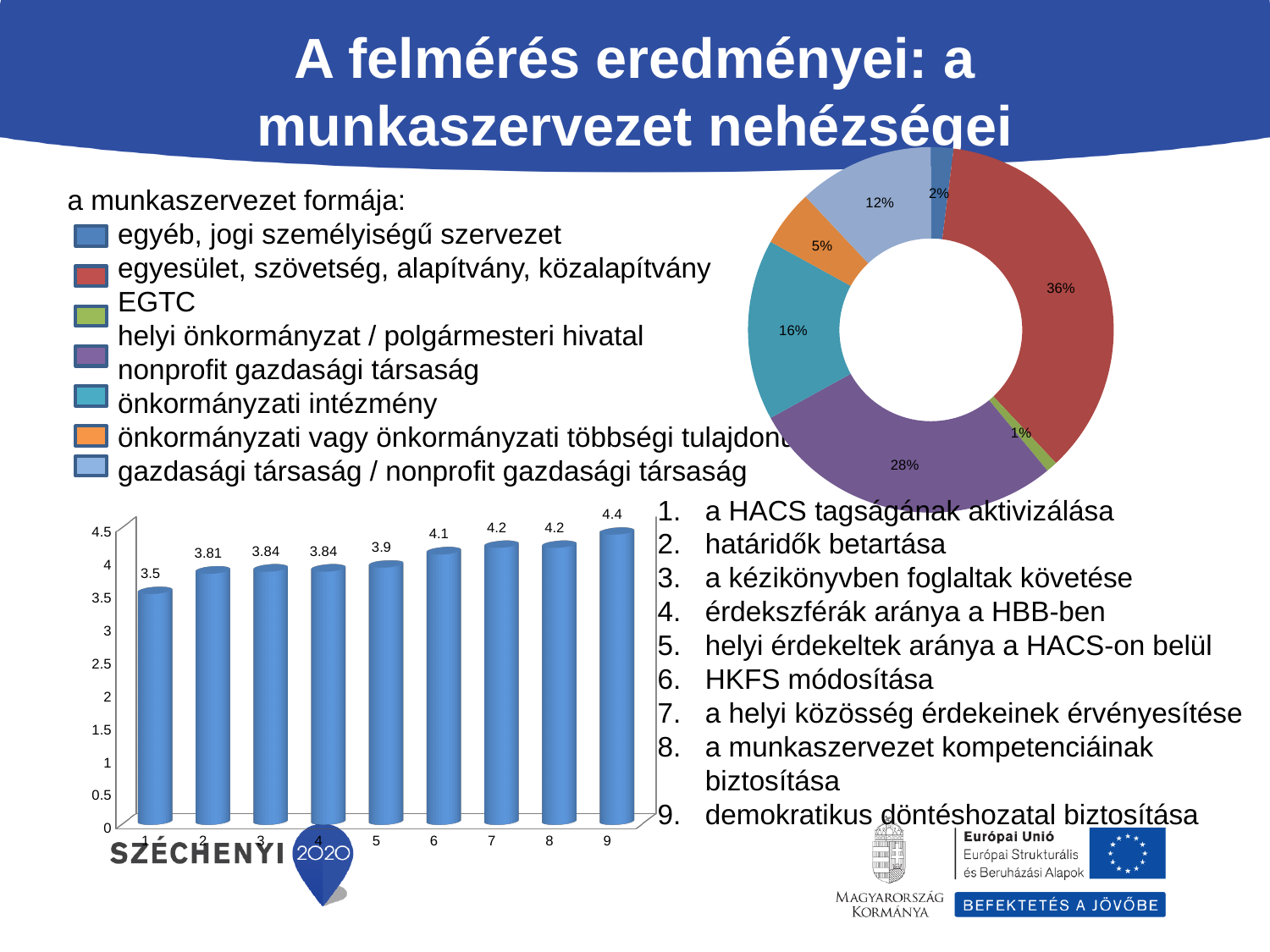
In the bar chart at the bottom left, what is the value for category 1? 3.5 In the bar chart at the bottom left, how many categories are plotted? 9 In the doughnut chart at the top right, what share is shown for 'egyesület, szövetség, alapítvány, közalapítvány' (the red slice)? 36% What type of chart is the chart at the bottom left of the slide? bar chart In the bar chart at the bottom left, what is the difference between the values for category 9 and category 1? 0.9 In the bar chart at the bottom left, which category has the highest value? 9 In the doughnut chart at the top right, which category has the largest slice? egyesület, szövetség, alapítvány, közalapítvány In the bar chart at the bottom left, what is the value for category 5? 3.9 In the doughnut chart at the top right, what share is shown for 'helyi önkormányzat / polgármesteri hivatal' (the purple slice)? 28% In the bar chart at the bottom left, which category has the lowest value? 1 In the bar chart at the bottom left, which is larger: the value for category 6 or category 5? category 6 In the bar chart at the bottom left, do the values generally rise or fall from category 1 to category 9? rise